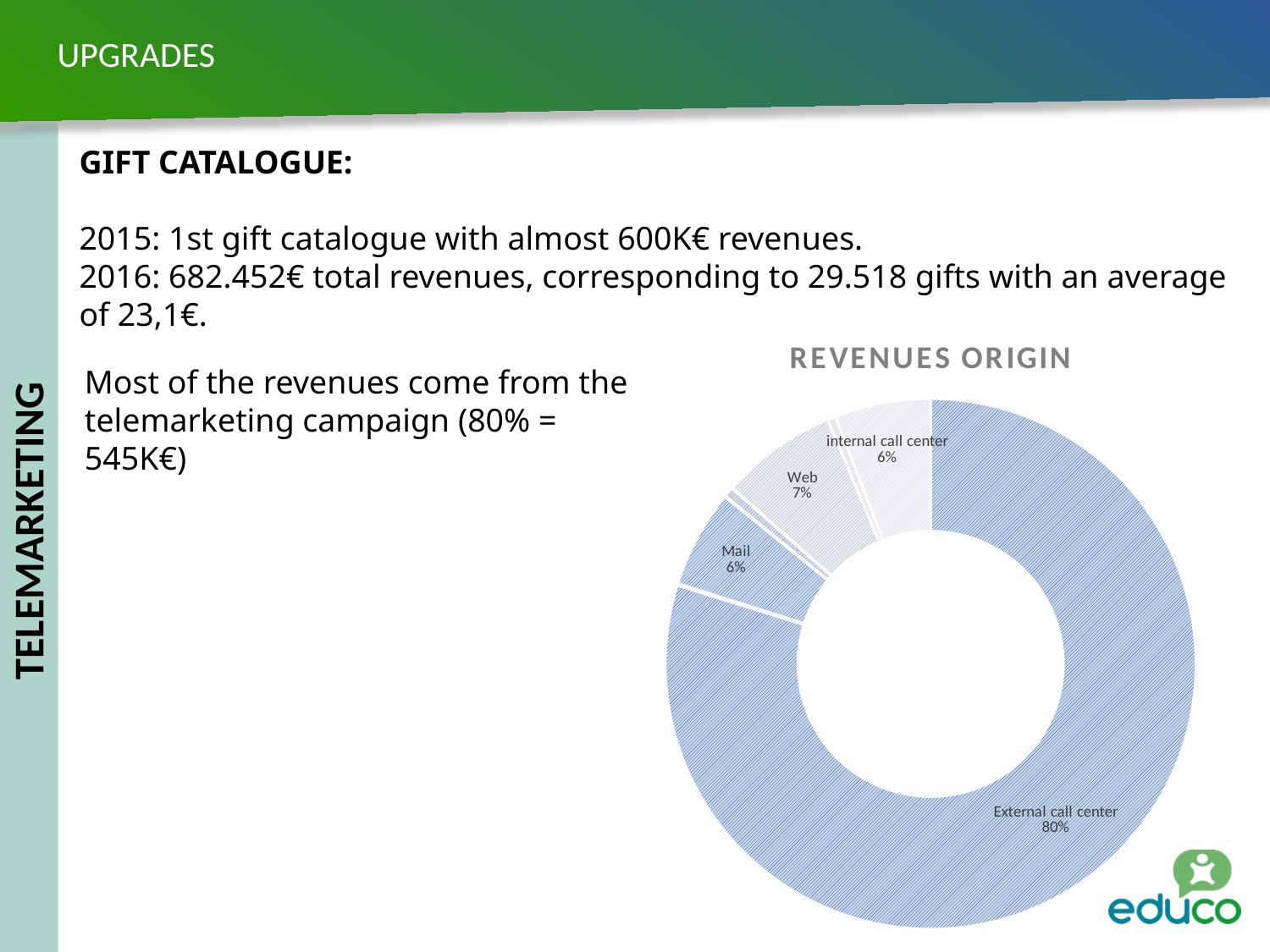
What percentage is shown for the internal call center? 6% Which category has the largest share in the REVENUES ORIGIN chart? External call center What share of revenues comes from the External call center? 80% Which category in the REVENUES ORIGIN chart is labelled with 80%? External call center What percentage is shown for Web in the REVENUES ORIGIN chart? 7% What is the title of the chart on the slide? REVENUES ORIGIN What percentage is shown for Mail in the REVENUES ORIGIN chart? 6% What kind of chart is shown on the slide? doughnut (pie) chart Which has the larger share, Web or Mail? Web What is the difference in percentage points between the External call center and Web shares? 73% What is the difference in percentage points between the Web and Mail shares? 1%